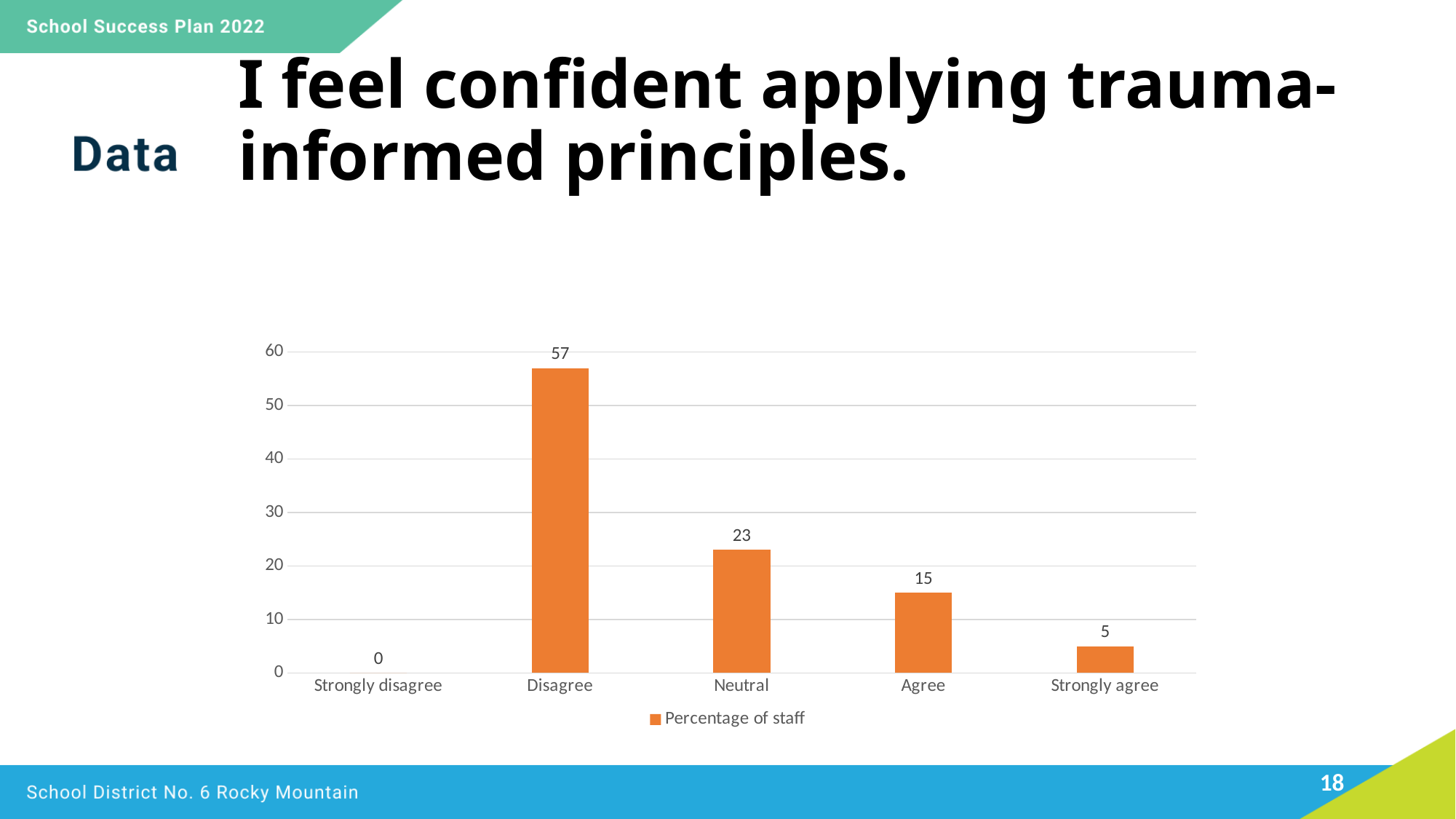
What is the difference between the values for Disagree and Neutral? 34 What is the value for Agree? 15 What is the value for Strongly disagree? 0 Which is larger, the value for Agree or the value for Strongly agree? Agree What kind of chart is shown on the slide? Bar chart How many categories are shown on the x axis? 5 Which category has the highest value? Disagree What series name does the legend show? Percentage of staff Which category has the lowest value? Strongly disagree What is the value for Disagree? 57 What is the value for Neutral? 23 What is the value for Strongly agree? 5